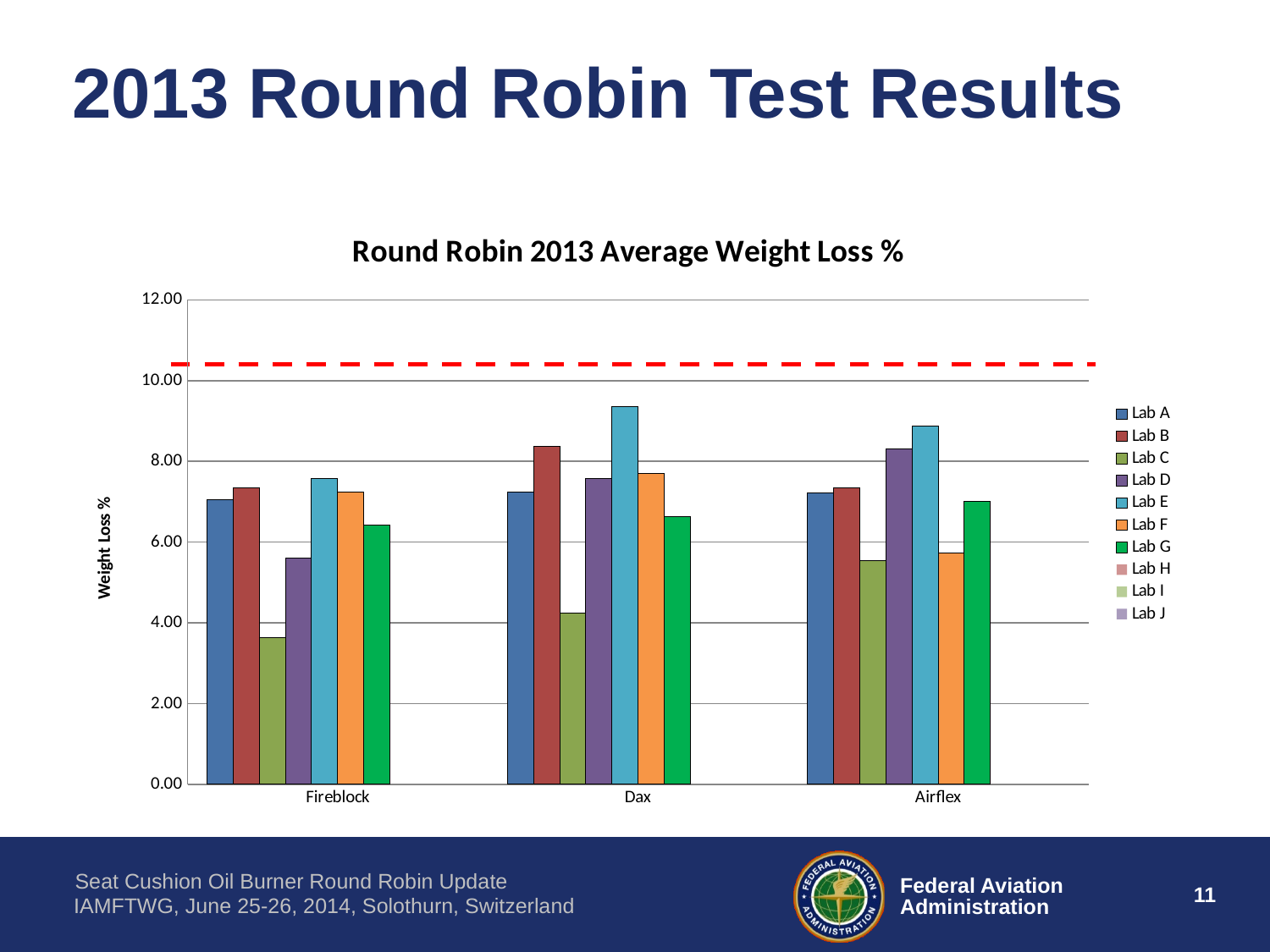
What is the title of the chart? Round Robin 2013 Average Weight Loss % What is the label of the y axis? Weight Loss % Do Lab C's values rise or fall moving from Fireblock to Dax to Airflex? rise How many series does the legend list? 10 Which lab has the highest weight loss for Airflex? Lab E What kind of chart is shown on the slide? bar chart How many material categories are shown on the x axis? 3 Is the value for Lab E on Dax greater or less than 8.00? greater Which lab has the highest weight loss for Dax? Lab E Which lab has the lowest weight loss for Fireblock? Lab C Which is larger, Lab B's value for Dax or Lab B's value for Fireblock? Lab B's value for Dax Is the value for Lab C on Fireblock greater or less than 4.00? less